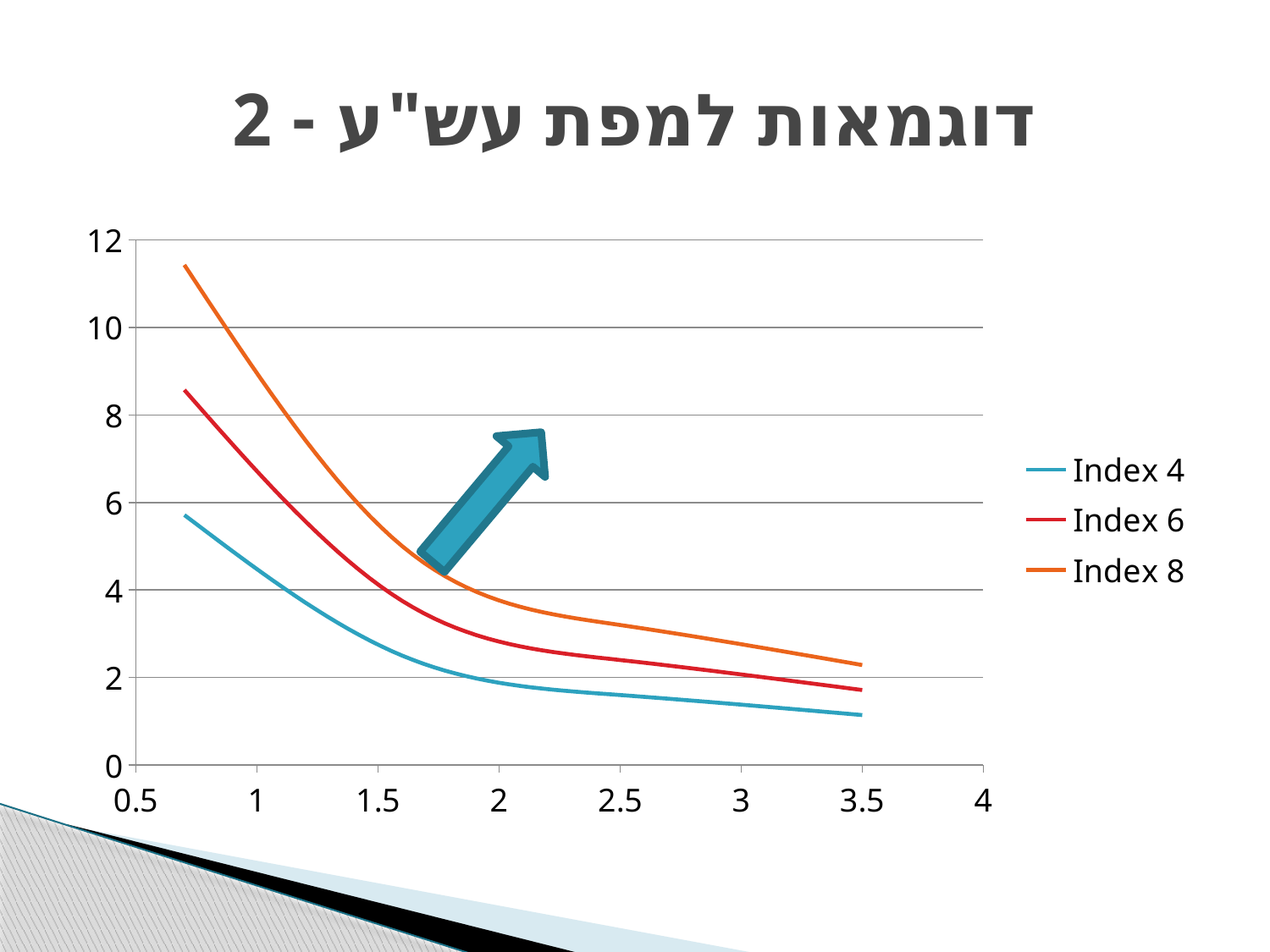
At x = 1, which is larger: Index 8 or Index 4? Index 8 Is the value of Index 4 at x = 3.5 greater or less than 2? less Is the value of Index 6 at x = 1 greater or less than 8? less What colour is the line for the Index 6 series? red Is the value of Index 4 at x = 1 greater or less than 4? greater Do the values of the Index 6 series rise or fall as x increases? fall What kind of chart is shown on the slide? line chart Which series has the lowest values across the chart? Index 4 What are the names of the series in the legend? Index 4, Index 6, Index 8 How many series does the legend list? 3 Which series has the highest values across the chart? Index 8